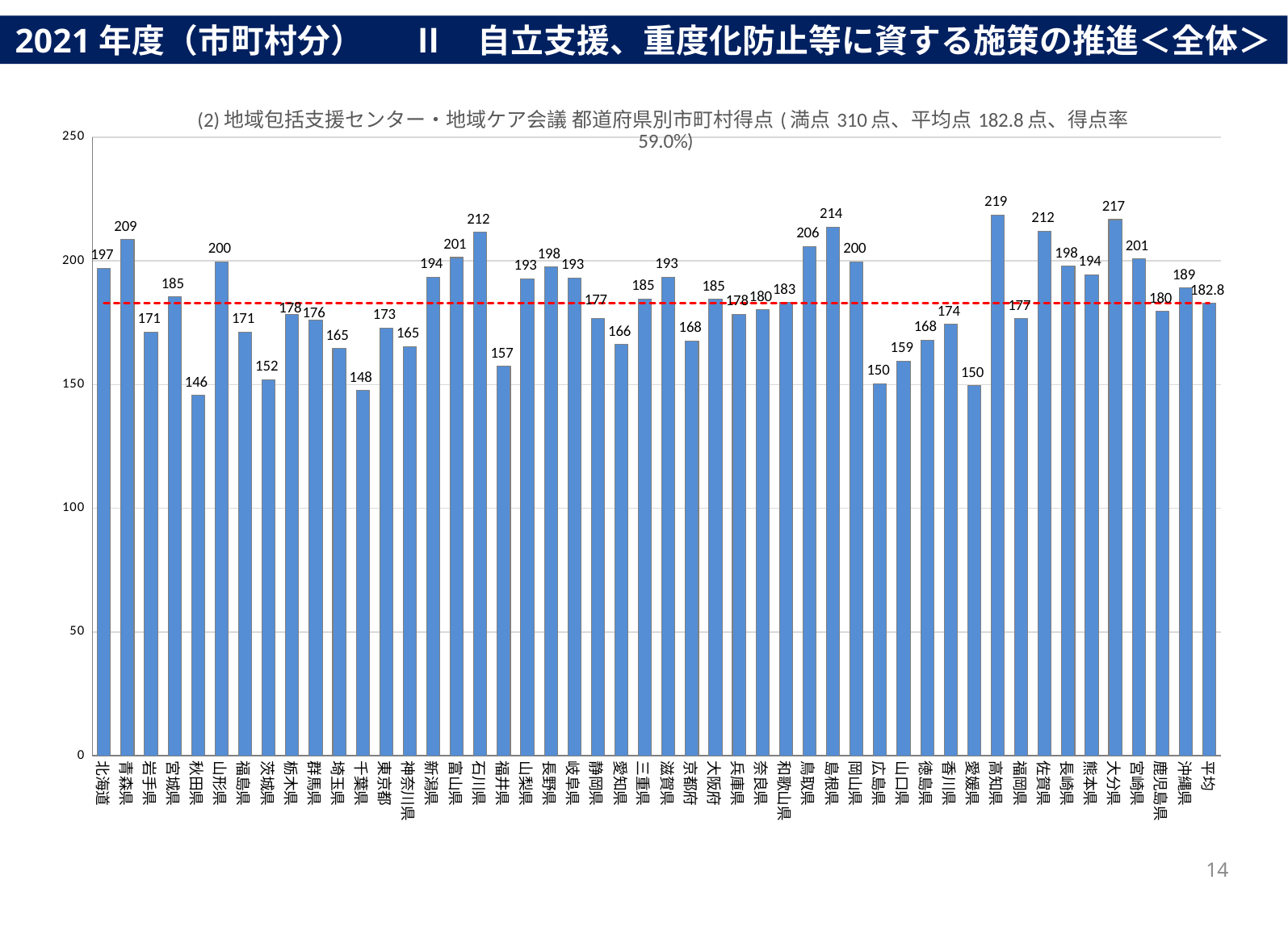
Which prefecture has the highest value? 高知県 What is the difference between the values for 高知県 and 秋田県? 73 Which is larger, the value for 石川県 or the value for 福井県? 石川県 Is the value for 島根県 greater or less than 200? greater What is the value for 沖縄県? 189 What is the value for 高知県? 219 How many bars are plotted in the chart, including 平均? 48 What is the value shown for 平均? 182.8 What is the value for 秋田県? 146 Which prefecture has the lowest value? 秋田県 What does the red dashed horizontal line represent, according to the chart title? 平均点 182.8点 What kind of chart is shown? bar chart